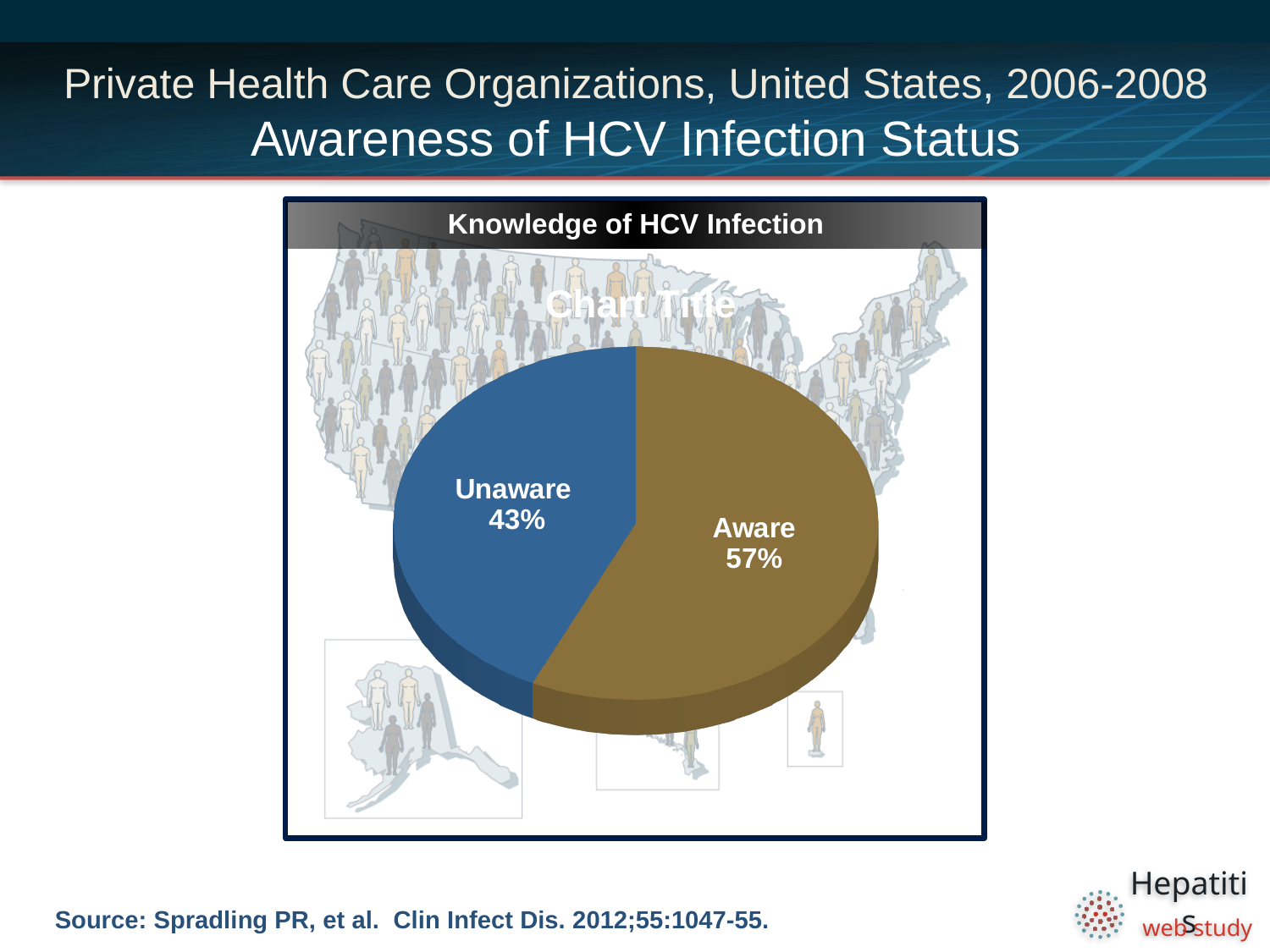
How many slices does the pie chart have? 2 What kind of chart is shown on the slide? pie chart What colour is the Unaware slice of the pie chart? blue What percentage of the pie chart is labelled Unaware? 43% What is the difference in percentage points between the Aware and Unaware slices? 14 What percentage of the pie chart is labelled Aware? 57% What is the heading printed above the pie chart? Knowledge of HCV Infection What share of the pie does the Aware slice represent? 57% Which is larger, the Aware slice or the Unaware slice? Aware Which slice of the pie chart is the smallest? Unaware Is the value for Unaware greater or less than 50%? less Which slice of the pie chart is the largest? Aware